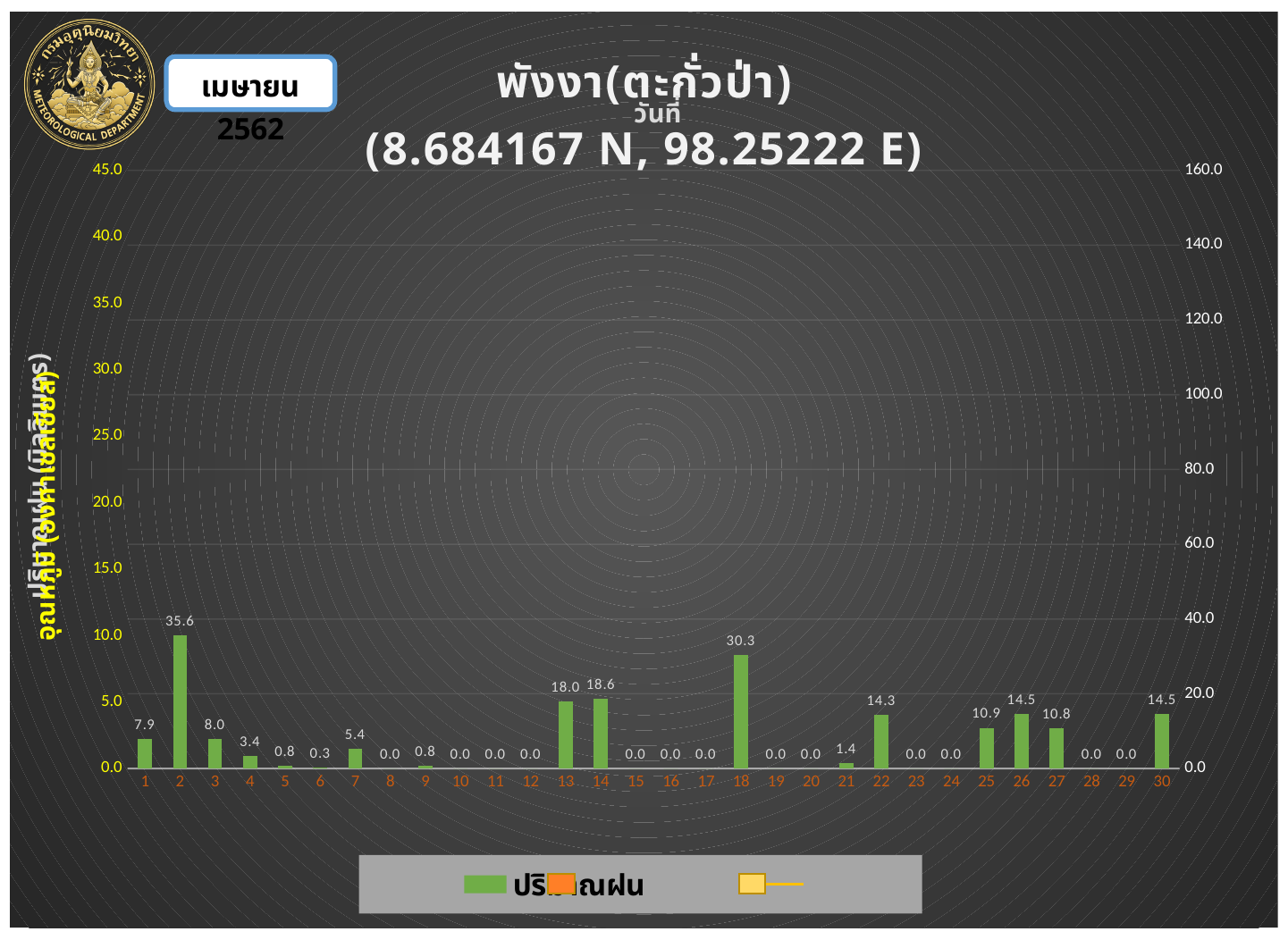
What is the difference between the values for day 2 and day 18? 5.3 What is the value shown for day 25? 10.9 What is the difference between the values for day 14 and day 13? 0.6 Which day has the highest value on the chart? 2 What is the value shown for day 18? 30.3 Which is larger, the value for day 22 or the value for day 27? day 22 What kind of chart is used to show the daily values? bar chart What is the value shown for day 14? 18.6 What is the rainfall value shown for day 2? 35.6 Which is larger, the value for day 1 or the value for day 3? day 3 How many days are shown on the x axis of the chart? 30 What coordinates are given in the chart title? 8.684167 N, 98.25222 E